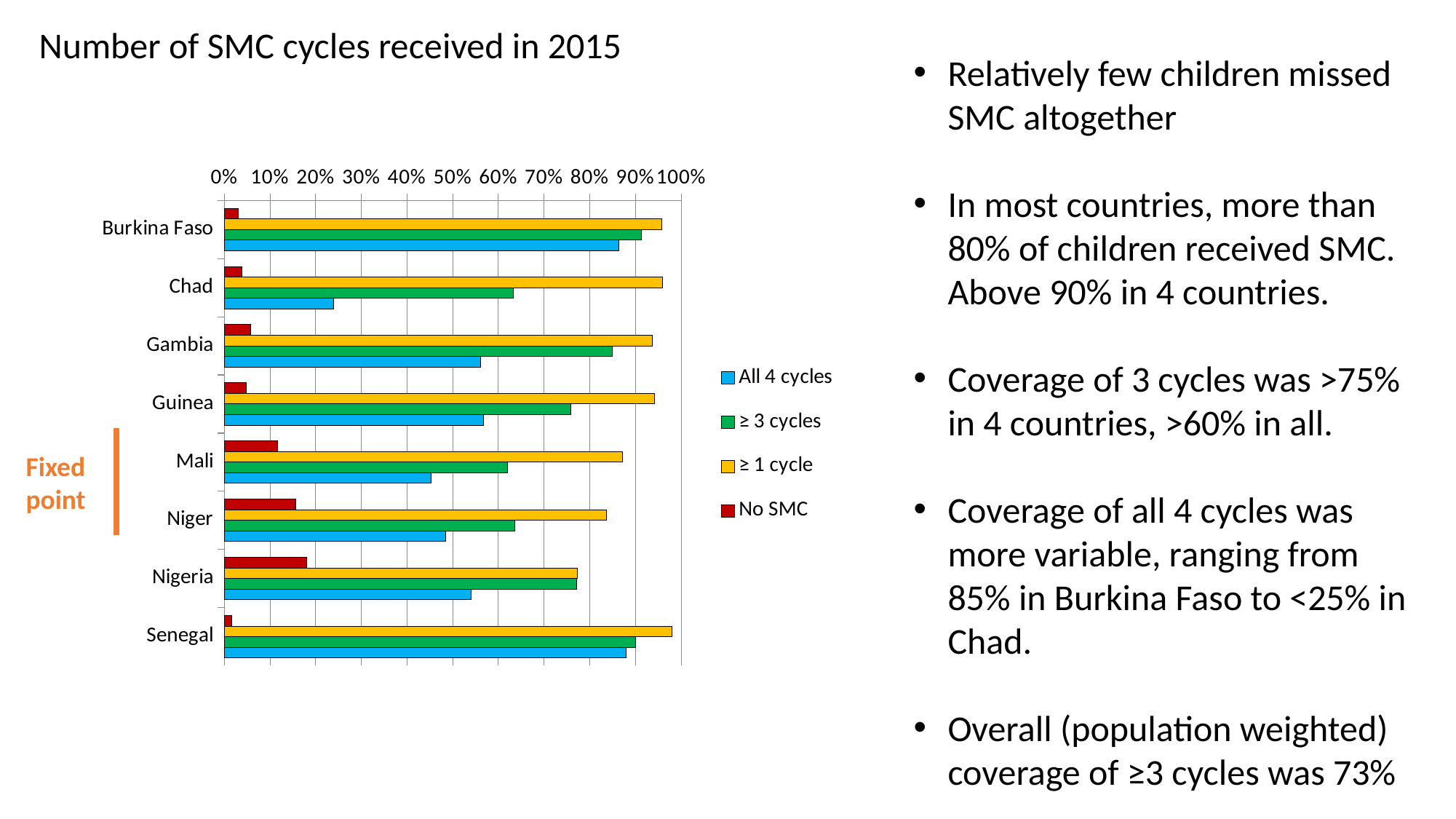
What kind of chart is shown on the slide? bar chart Which series is shown in red in the chart? No SMC Which is larger, the All 4 cycles value for Gambia or for Chad? Gambia Which country has the lowest value for ≥ 1 cycle? Nigeria Which country has the lowest value for All 4 cycles? Chad How many countries are shown on the chart? 8 Is the No SMC value for Nigeria greater or less than 10%? greater Is the All 4 cycles value for Chad greater or less than 30%? less Is the All 4 cycles value for Burkina Faso greater or less than 80%? greater How many series does the chart's legend list? 4 What is the title of the chart? Number of SMC cycles received in 2015 Which is larger, the No SMC value for Nigeria or for Senegal? Nigeria